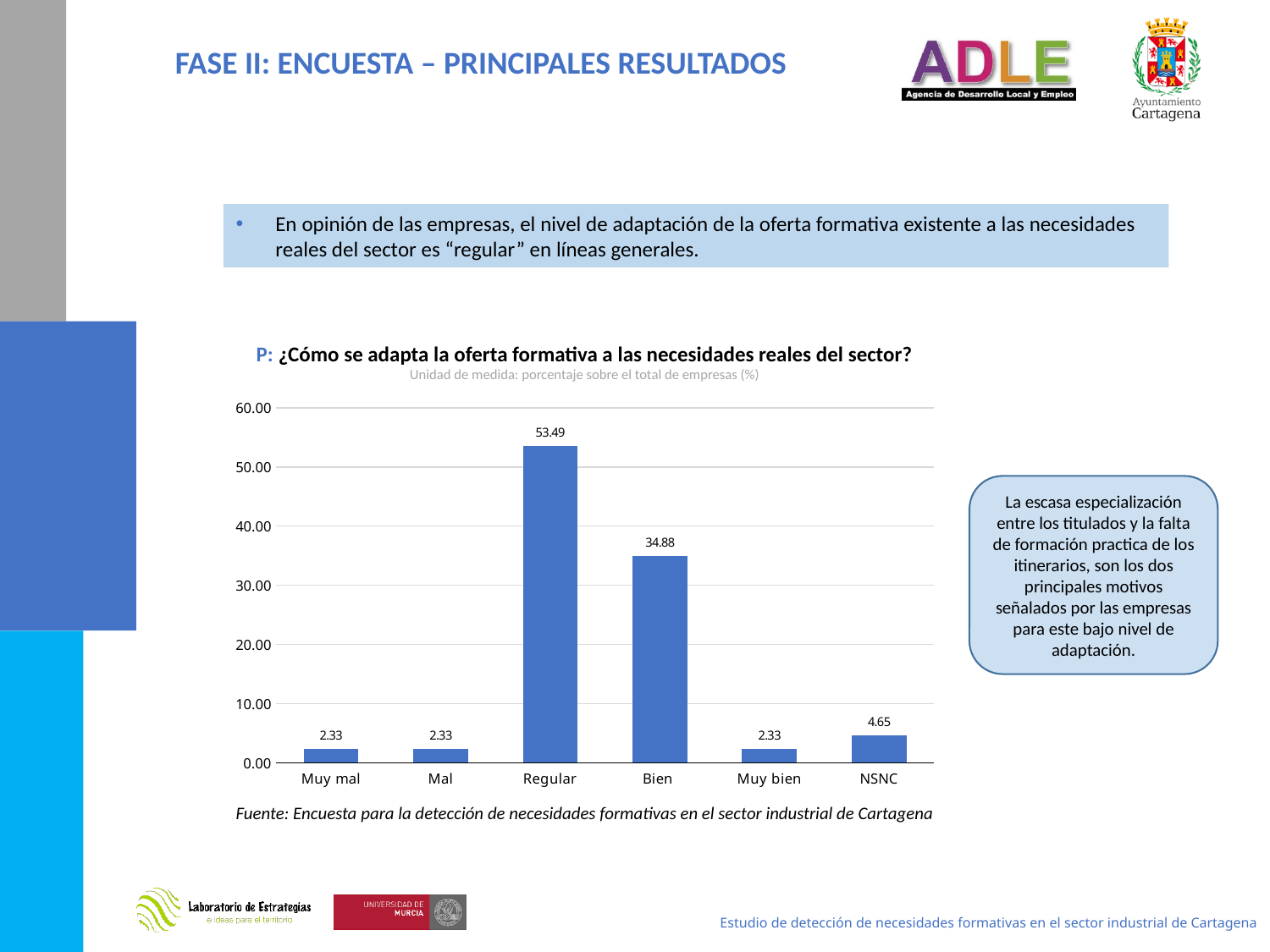
What is the value for NSNC? 4.65 What is the value for Muy mal? 2.33 Which category has the highest value? Regular What is the value for Regular? 53.49 What is the difference between the values for NSNC and Muy bien? 2.32 How many categories are shown on the x axis? 6 What kind of chart is shown on the slide? bar chart What is the difference between the values for Regular and Bien? 18.61 Which is larger, the value for Bien or the value for NSNC? Bien Is the value for Regular greater or less than 50.00? greater What unit of measure is stated under the chart title? porcentaje sobre el total de empresas (%) What is the value for Bien? 34.88